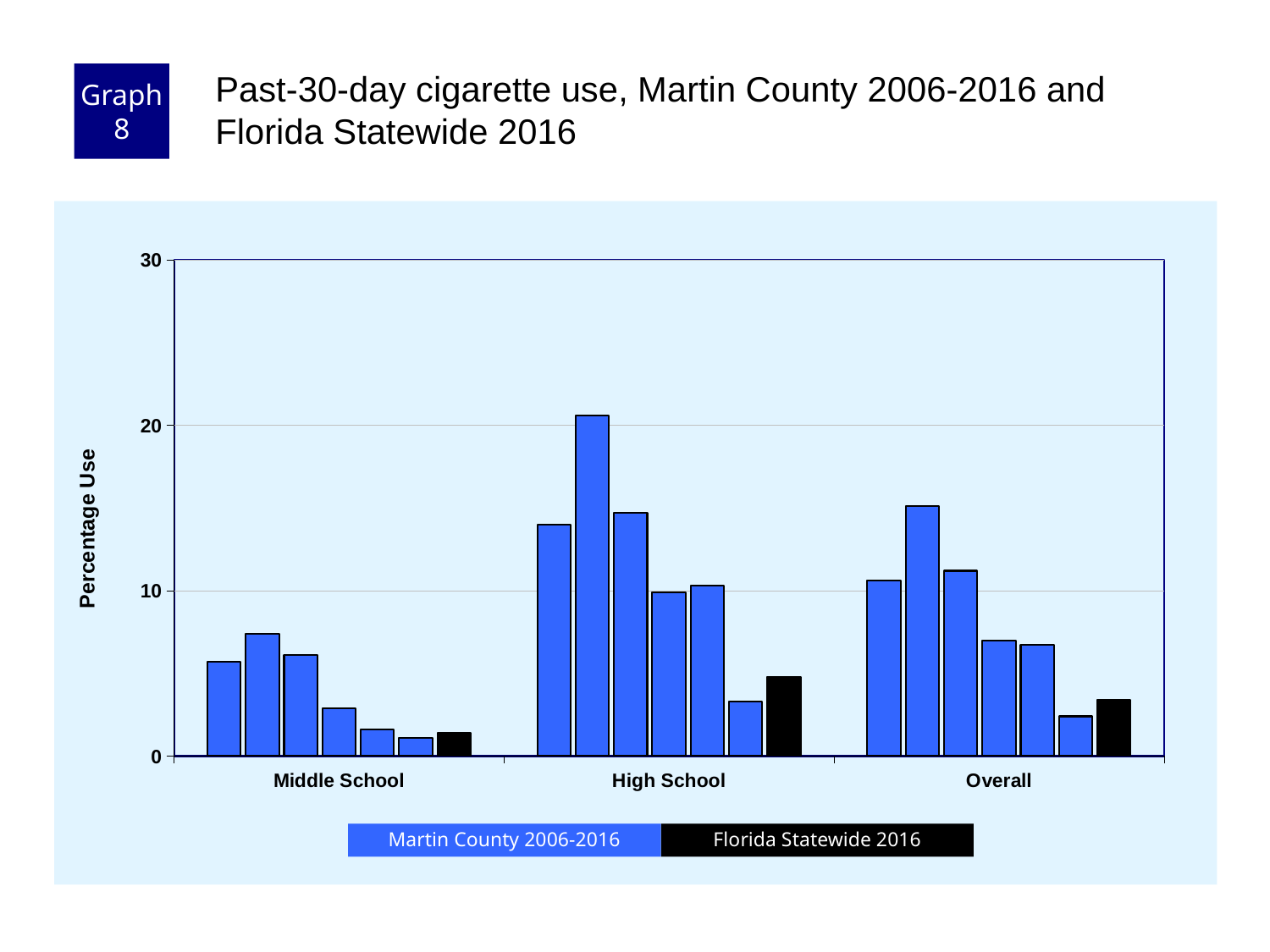
Is the Florida Statewide 2016 bar for High School greater or less than 10? less Which category contains the tallest bar in the chart? High School How many school-level categories are shown on the x axis? 3 What kind of chart is shown on the slide? bar chart In the Middle School group, is the last Martin County 2006-2016 bar higher or lower than the first? lower Is the tallest bar in the Middle School group greater or less than 10? less Is the tallest bar in the High School group greater or less than 20? greater Which category has the lowest Florida Statewide 2016 bar? Middle School What colour are the Florida Statewide 2016 bars? black How many series does the legend list? 2 Which is larger, the Florida Statewide 2016 bar for High School or the Florida Statewide 2016 bar for Overall? High School